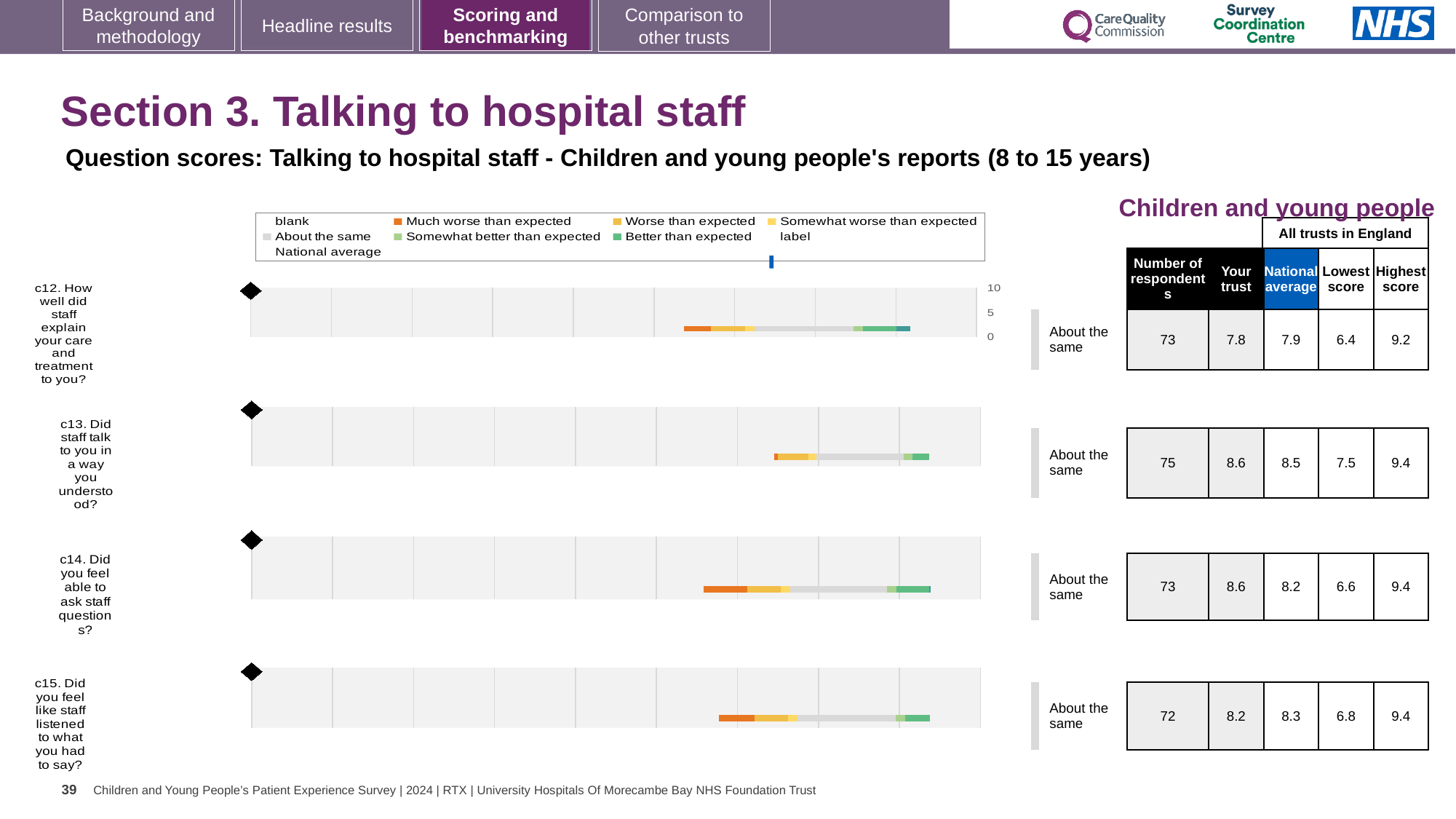
For c12 (How well did staff explain your care and treatment to you?), what is the 'Your trust' score? 7.8 What benchmark category is shown for c12 (How well did staff explain your care and treatment to you?)? About the same For c14, what is the difference between the 'Your trust' score and the national average? 0.4 For c15 (Did you feel like staff listened to what you had to say?), how many respondents were there? 72 Which question has the lowest 'Your trust' score? c12 For c12, what is the difference between the highest score and the lowest score among all trusts in England? 2.8 For c13 (Did staff talk to you in a way you understood?), what is the national average score? 8.5 Which question has the highest national average score? c13 What kind of chart is used for the question scores on this slide? bar chart For c14 (Did you feel able to ask staff questions?), what is the lowest score among all trusts in England? 6.6 For c15, which is larger: the 'Your trust' score or the national average? National average How many survey questions (c12 to c15) are plotted on the slide? 4